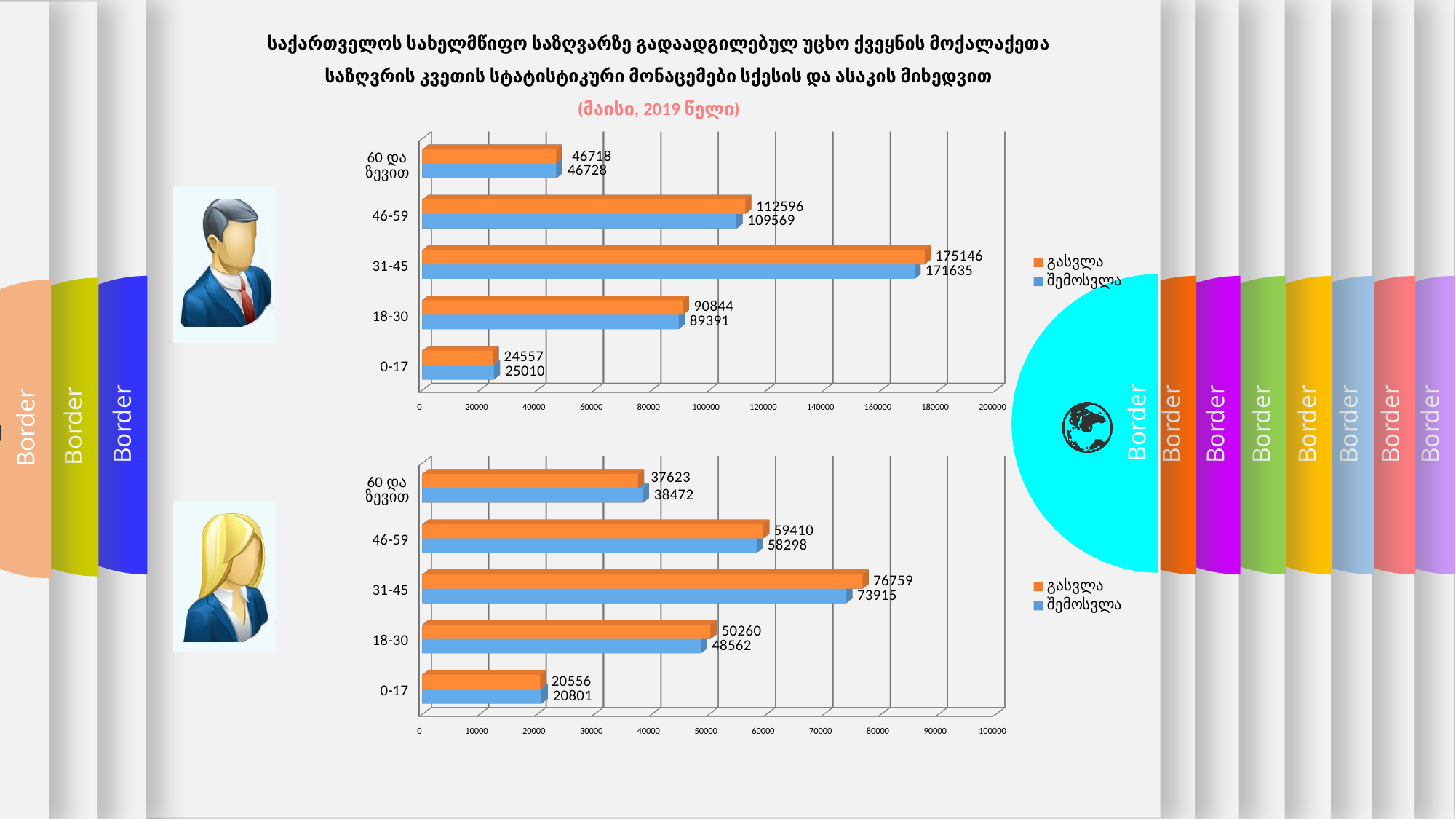
In the bottom chart, what is the difference between the გასვლა and შემოსვლა values for the 31-45 age group? 2844 In the top chart, what is the გასვლა value for the 31-45 age group? 175146 How many age groups are shown in the bottom chart? 5 What type of chart is the bottom chart? Bar chart In the top chart, which age group has the highest გასვლა value? 31-45 In the bottom chart, what is the შემოსვლა value for the 60 და ზევით age group? 38472 In the bottom chart, what is the გასვლა value for the 46-59 age group? 59410 How many series does the legend of the top chart list? 2 In the top chart, is the გასვლა value for the 18-30 age group greater or less than 100000? less In the top chart, what is the difference between the გასვლა and შემოსვლა values for the 46-59 age group? 3027 In the top chart, what is the შემოსვლა value for the 0-17 age group? 25010 In the bottom chart, which age group has the lowest შემოსვლა value? 0-17